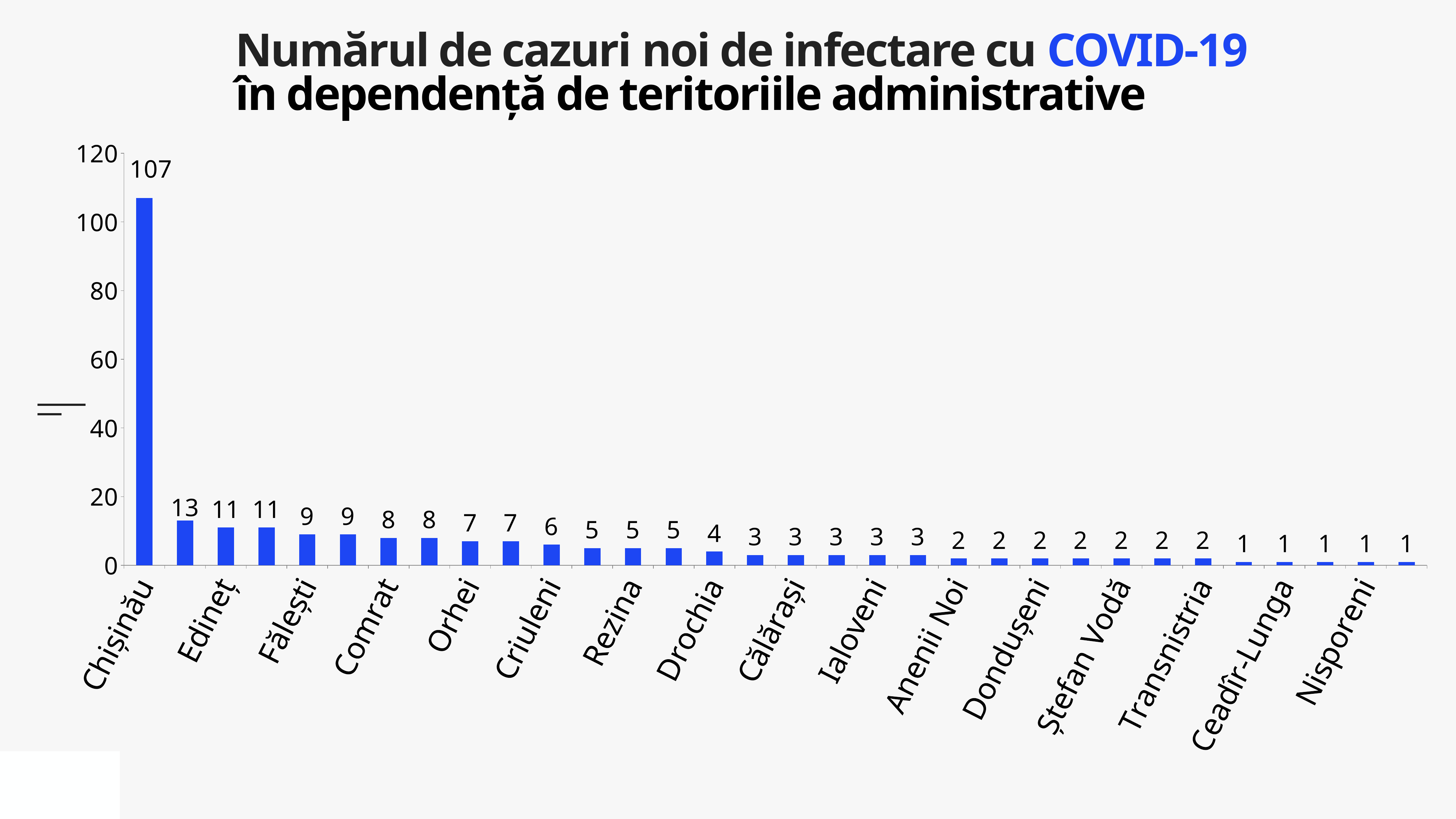
What is the difference between the values for Chișinău and Edineț? 96 What is the number of new COVID-19 cases for Chișinău? 107 Which has a larger value, Comrat or Ialoveni? Comrat What is the value shown for Edineț? 11 Which administrative territory has the highest number of new cases? Chișinău What is the value shown for Fălești? 9 What is the value shown for Orhei? 7 Do the values rise or fall moving from left to right along the x axis? fall What is the value shown for Nisporeni? 1 Is the value for Chișinău greater or less than 100? greater What type of chart is shown on the slide? bar chart Which word in the chart title is highlighted in blue? COVID-19